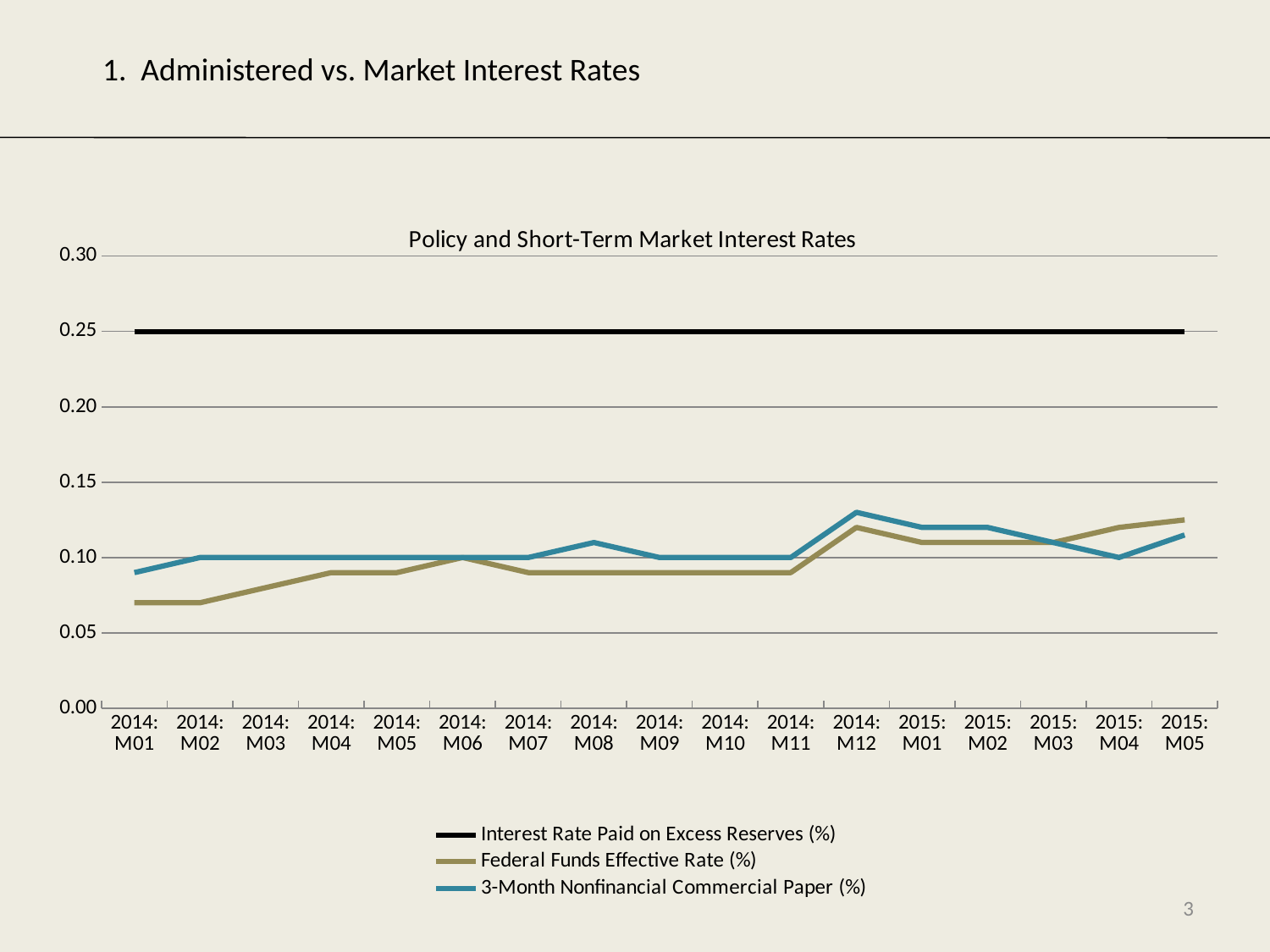
Is the Federal Funds Effective Rate (%) at 2014: M01 greater or less than 0.10? less How many series does the legend list? 3 At 2014: M01, which is higher: the Federal Funds Effective Rate (%) or the 3-Month Nonfinancial Commercial Paper (%)? 3-Month Nonfinancial Commercial Paper (%) What is the title of the chart? Policy and Short-Term Market Interest Rates How many time periods are shown on the x axis? 17 Which series has the highest values throughout the chart? Interest Rate Paid on Excess Reserves (%) What kind of chart is shown on the slide? line chart Does the Federal Funds Effective Rate (%) generally rise or fall from 2014: M01 to 2015: M05? rise What is the value of the Interest Rate Paid on Excess Reserves (%) series across the period shown? 0.25 In which period does the 3-Month Nonfinancial Commercial Paper (%) series reach its highest value? 2014: M12 In which period does the 3-Month Nonfinancial Commercial Paper (%) series reach its lowest value? 2014: M01 Is the 3-Month Nonfinancial Commercial Paper (%) value at 2014: M12 greater or less than 0.10? greater